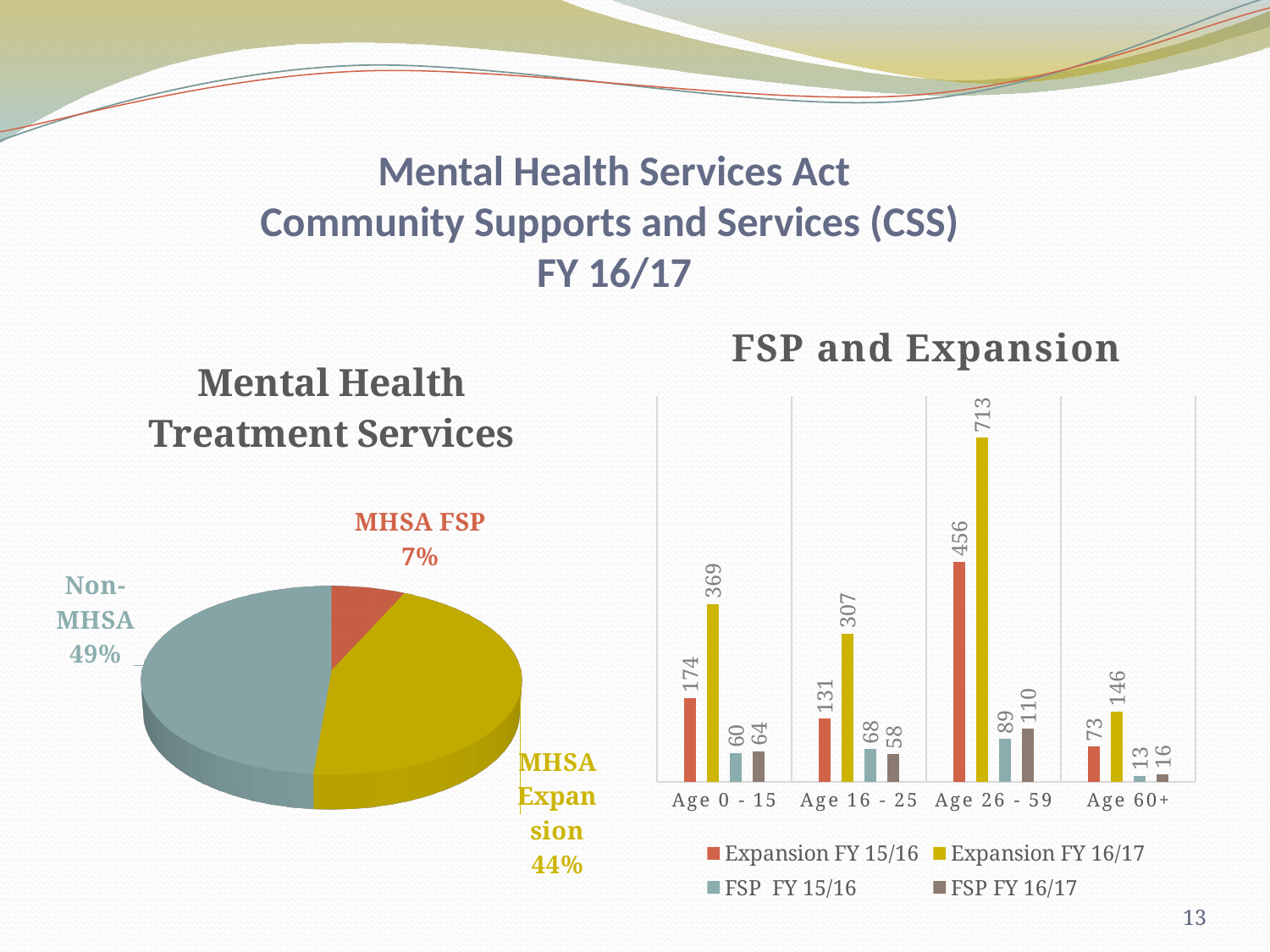
In the 'FSP and Expansion' chart, what is the difference between Expansion FY 16/17 and Expansion FY 15/16 for Age 0 - 15? 195 In the 'Mental Health Treatment Services' pie chart, what share is MHSA Expansion? 44% In the 'FSP and Expansion' chart, what is the value for Expansion FY 15/16 for Age 16 - 25? 131 In the 'FSP and Expansion' chart, which is larger for Age 16 - 25: FSP FY 15/16 or FSP FY 16/17? FSP FY 15/16 What kind of chart is 'Mental Health Treatment Services'? Pie chart In the 'FSP and Expansion' chart, which age group has the highest Expansion FY 16/17 value? Age 26 - 59 In the 'FSP and Expansion' chart, what is the value for FSP FY 15/16 for Age 60+? 13 How many age groups are shown in the 'FSP and Expansion' chart? 4 In the 'FSP and Expansion' chart, which age group has the lowest FSP FY 16/17 value? Age 60+ In the 'FSP and Expansion' chart, what is the value for Expansion FY 16/17 for Age 26 - 59? 713 In the 'Mental Health Treatment Services' pie chart, which slice is the smallest? MHSA FSP How many series does the legend of the 'FSP and Expansion' chart list? 4